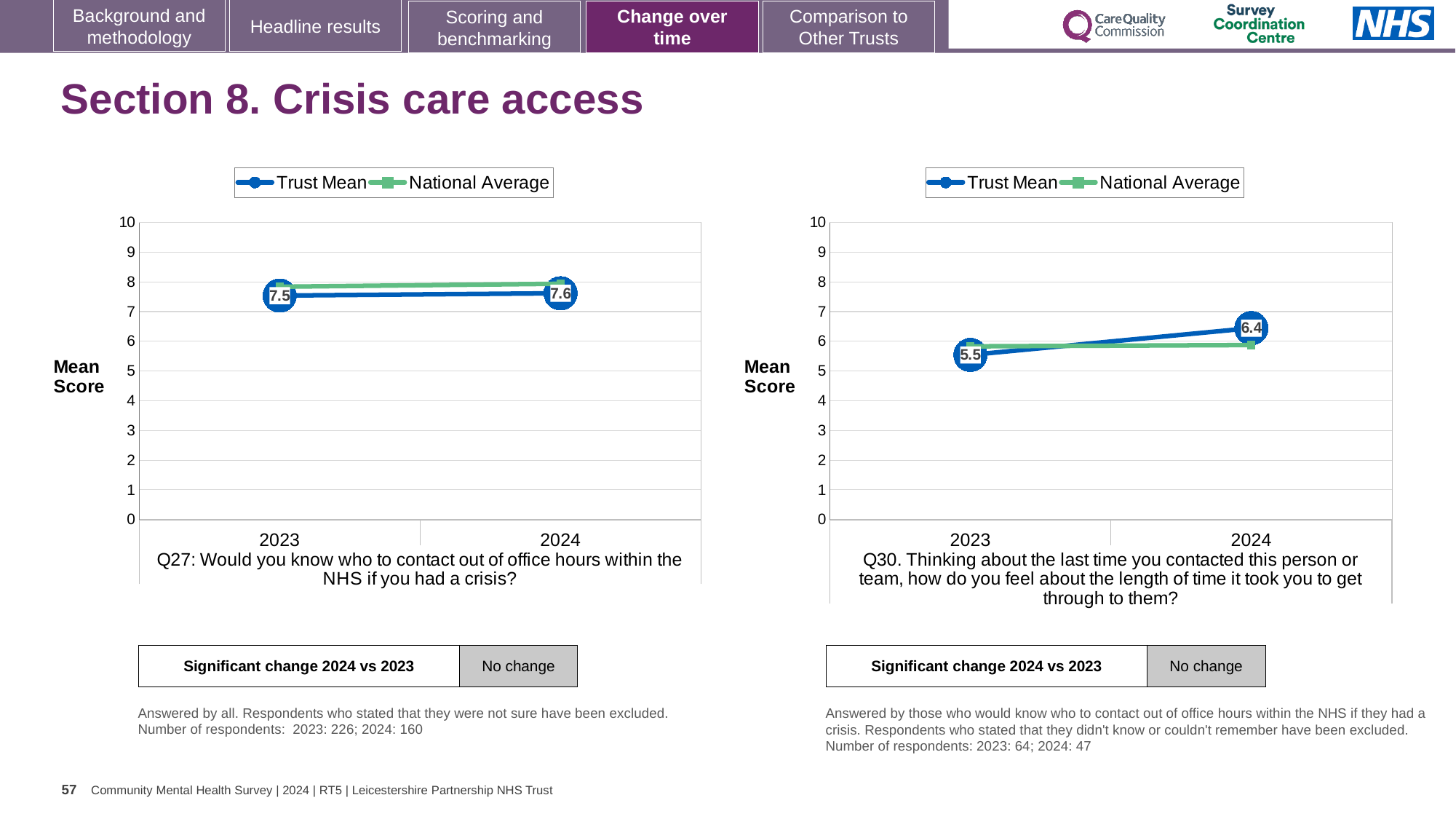
In the Q27 chart on the left, what is the Trust Mean score for 2024? 7.6 In the Q30 chart on the right, does the Trust Mean rise or fall from 2023 to 2024? rise In the Q30 chart on the right, which is larger in 2024, the Trust Mean or the National Average? Trust Mean What is the y-axis label on the Q27 chart on the left? Mean Score In the Q30 chart on the right, what is the Trust Mean score for 2023? 5.5 In the Q27 chart on the left, is the National Average value for 2023 greater or less than 7? greater In the Q30 chart on the right, by how much did the Trust Mean change from 2023 to 2024? 0.9 How many series does the legend of the Q30 chart on the right list? 2 In the Q30 chart on the right, what is the Trust Mean score for 2024? 6.4 In the Q27 chart on the left, by how much did the Trust Mean change from 2023 to 2024? 0.1 What type of chart is used for Q27 on the left? line chart In the Q27 chart on the left, what is the Trust Mean score for 2023? 7.5